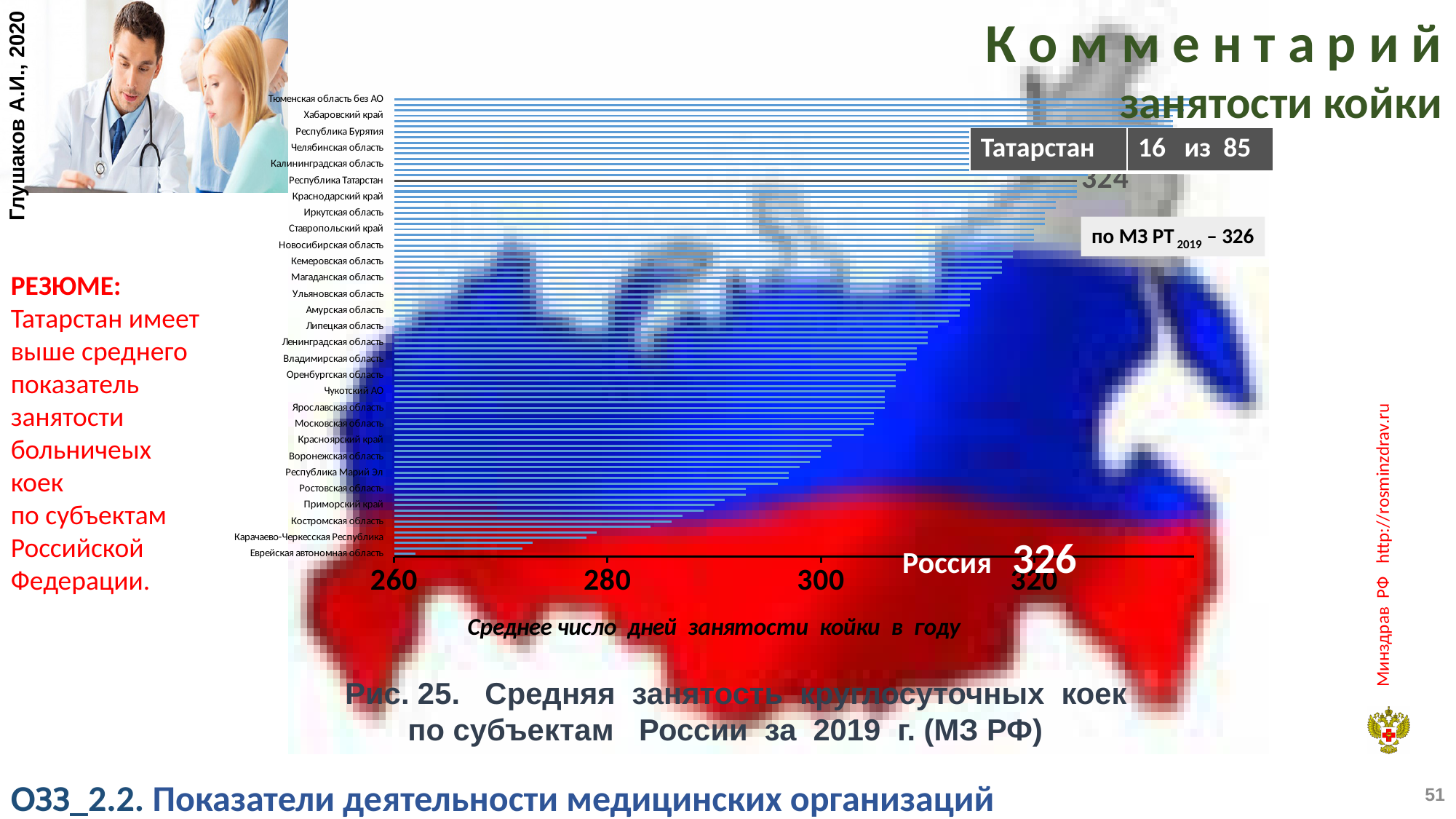
Is the value for Костромская область greater or less than 280? greater Is the value for Еврейская автономная область greater or less than 280? less Do the bar values increase or decrease going from the top of the chart to the bottom? decrease Is the value for Московская область greater or less than 300? greater Which region is listed at the bottom of the chart? Еврейская автономная область What kind of chart is shown on the slide? bar chart What is the value shown for Россия on the chart? 326 Which region is listed at the top of the chart? Тюменская область без АО Which has the larger value, Хабаровский край or Еврейская автономная область? Хабаровский край What value is labelled for Республика Татарстан? 324 What is the x-axis title of the chart? Среднее число дней занятости койки в году